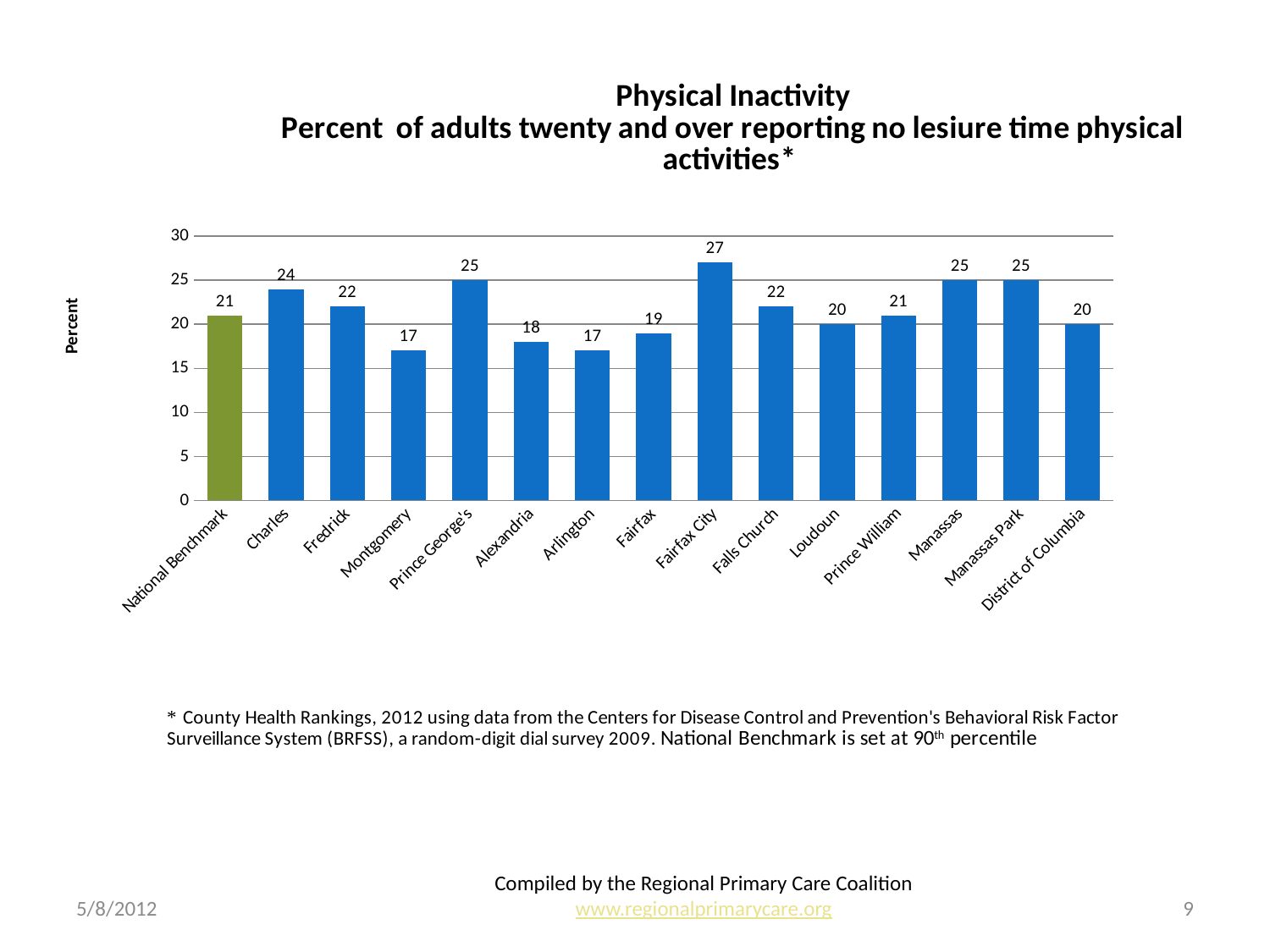
What colour is the National Benchmark bar? Green Which jurisdiction has the highest percent of physical inactivity? Fairfax City What is the lowest value shown on the chart? 17 What kind of chart is shown on the slide? Bar chart Which is larger, the value for Charles or the value for Fredrick? Charles What is the value for the National Benchmark? 21 What is the value for Fairfax City? 27 What is the value for Alexandria? 18 What is the value for Loudoun? 20 How much higher is Prince George's than the National Benchmark? 4 What is the difference between the values for Fairfax City and Montgomery? 10 How many categories are shown on the x axis? 15